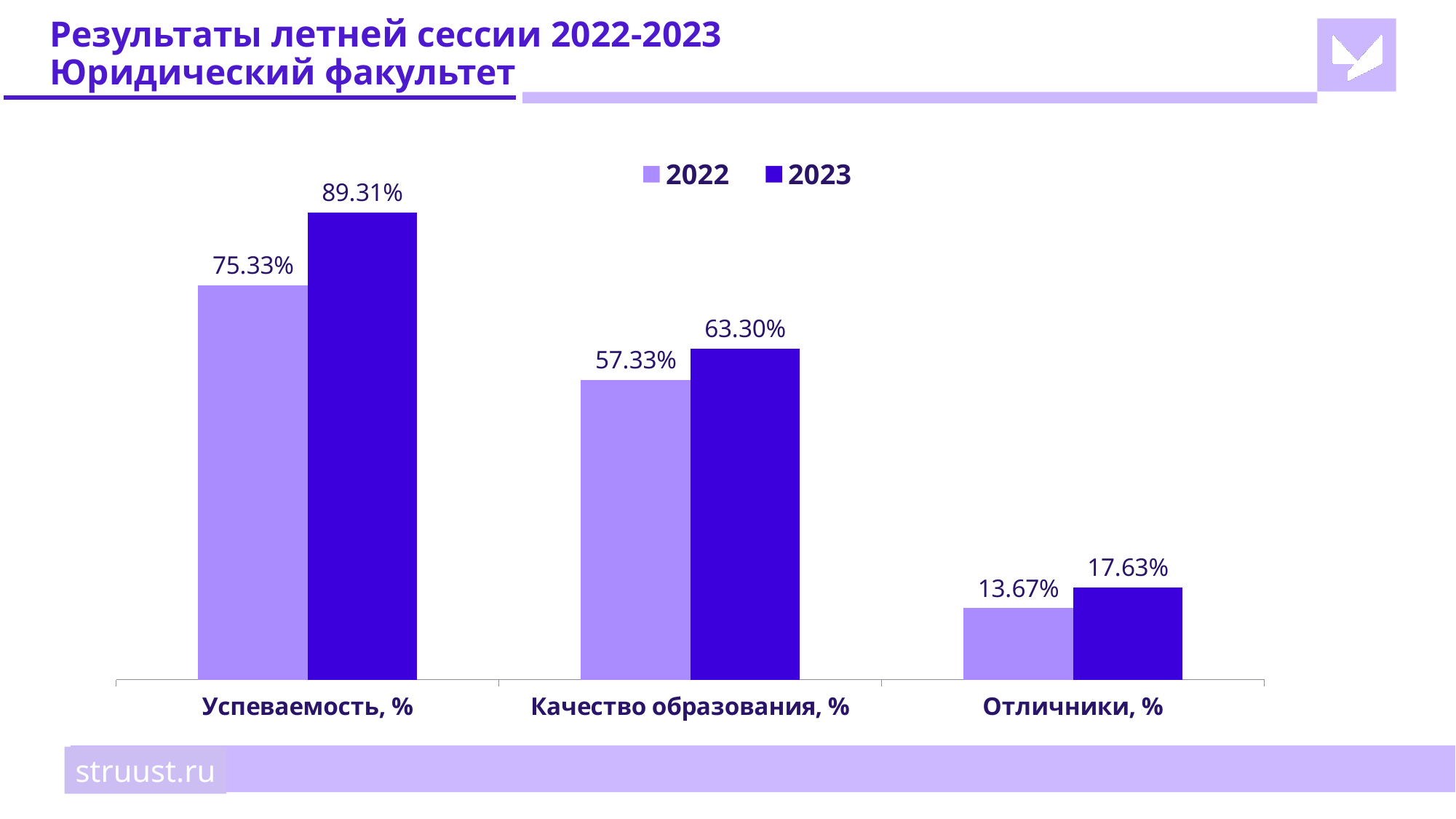
What is the value for Успеваемость, % in 2022? 75.33% How many series does the legend list? 2 How many categories are shown on the x axis? 3 What is the value for Успеваемость, % in 2023? 89.31% Which category has the lowest value for 2022? Отличники, % What is the difference between the 2023 and 2022 values for Отличники, %? 3.96% What is the value for Отличники, % in 2023? 17.63% What is the difference between the 2023 and 2022 values for Успеваемость, %? 13.98% Which category has the highest value for 2023? Успеваемость, % Which is larger for Качество образования, %: the 2022 value or the 2023 value? 2023 What kind of chart is shown on the slide? Bar chart What is the value for Качество образования, % in 2022? 57.33%